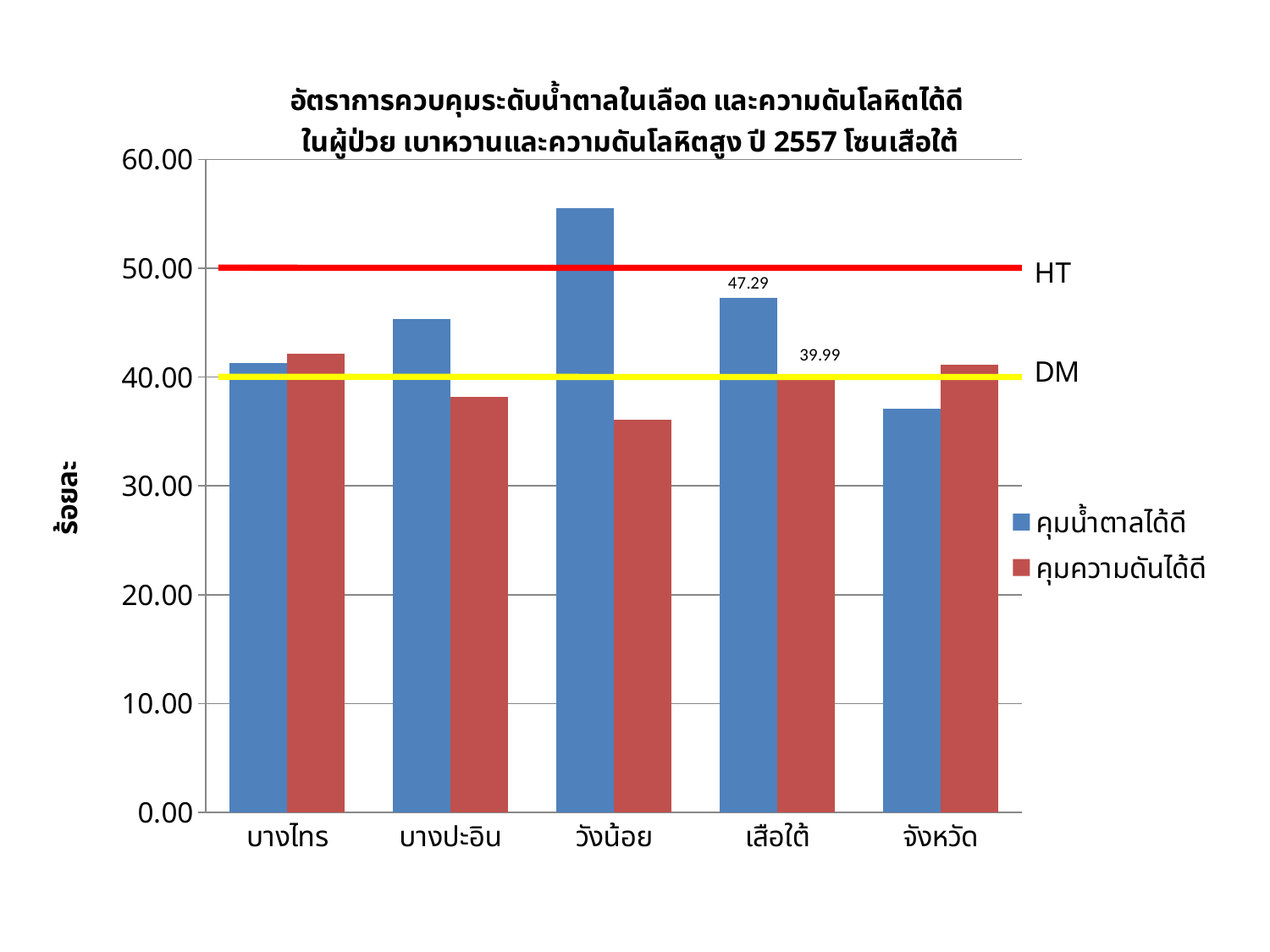
What is the value of คุมน้ำตาลได้ดี for เสือใต้? 47.29 Which category has the highest value for คุมน้ำตาลได้ดี? วังน้อย Is the value of คุมน้ำตาลได้ดี for จังหวัด greater or less than 40.00? less What kind of chart is shown on the slide? bar chart Which category has the lowest value for คุมความดันได้ดี? วังน้อย How many categories are shown on the x axis? 5 Is the value of คุมน้ำตาลได้ดี for วังน้อย greater or less than 50.00? greater What is the difference between คุมน้ำตาลได้ดี and คุมความดันได้ดี for เสือใต้? 7.30 What is the value of คุมความดันได้ดี for เสือใต้? 39.99 Which category has the lowest value for คุมน้ำตาลได้ดี? จังหวัด How many series does the legend list? 2 For วังน้อย, which is larger: คุมน้ำตาลได้ดี or คุมความดันได้ดี? คุมน้ำตาลได้ดี